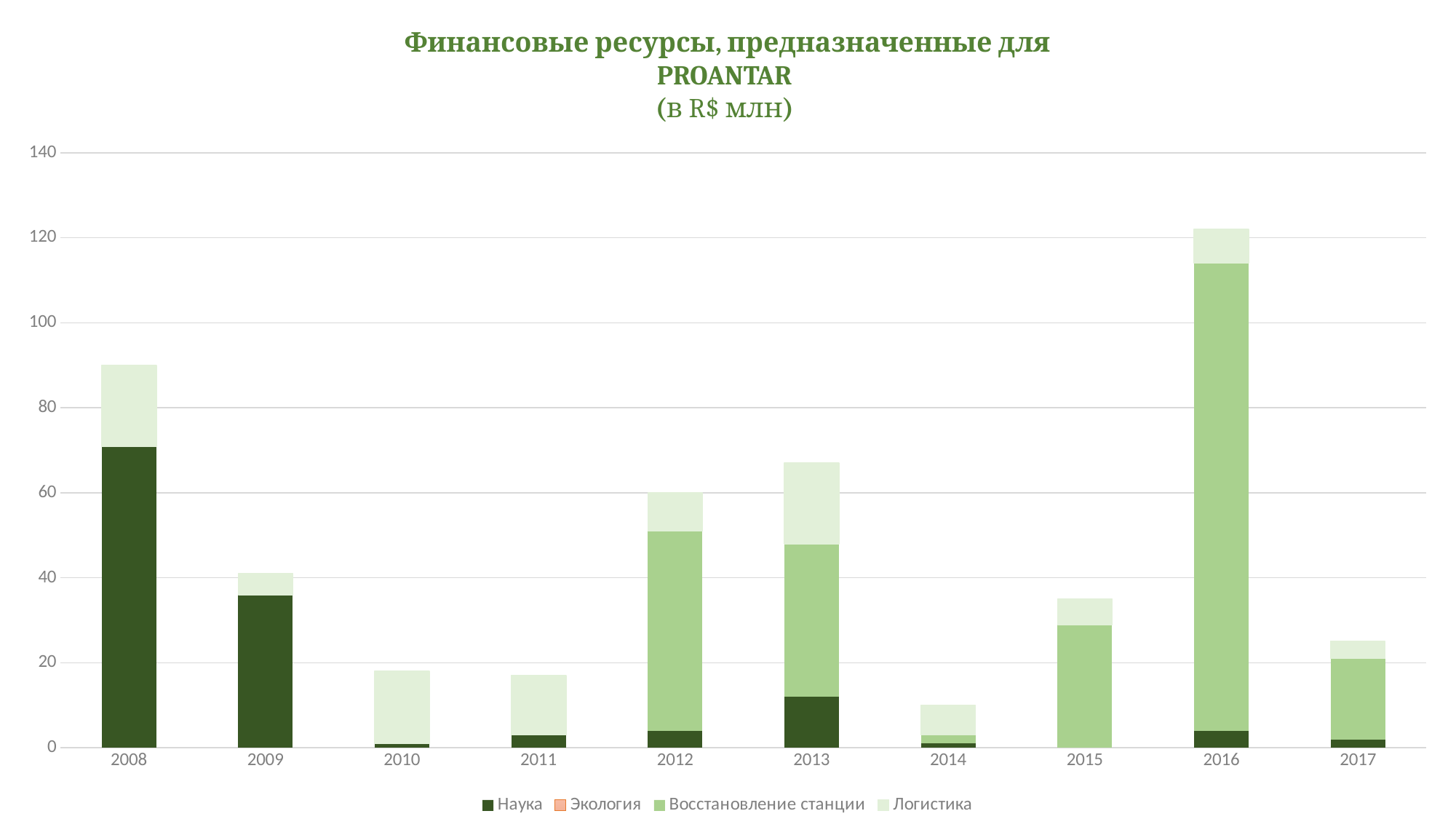
Is the total value for 2008 greater or less than 100? less Is the total value for 2015 greater or less than 40? less Which year has the larger total bar, 2008 or 2009? 2008 Which year has the highest total bar in the chart? 2016 Which year has the larger total bar, 2012 or 2013? 2013 Which series is shown in the darkest green colour in the legend? Наука What kind of chart is shown on the slide? Stacked bar chart How many series does the chart's legend list? 4 Which year has the lowest total bar in the chart? 2014 How many years are shown on the x axis of the chart? 10 Is the total value for 2014 greater or less than 20? less